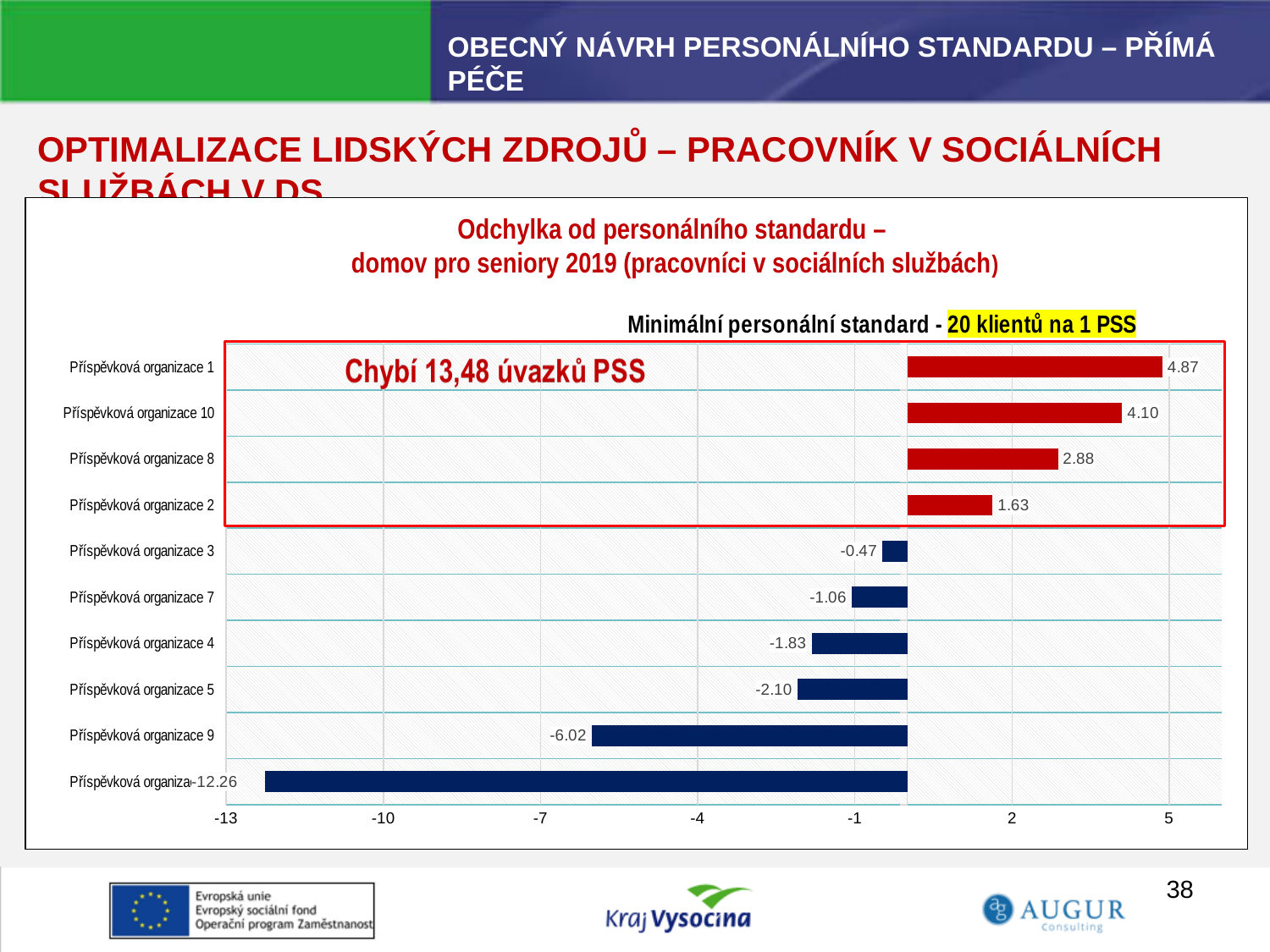
What is the value for Příspěvková organizace 1? 4.87 What minimum personnel standard is stated above the chart? 20 klientů na 1 PSS Is the value for Příspěvková organizace 9 greater or less than -4? less What type of chart is shown on the slide? bar chart What is the lowest value shown in the chart? -12.26 What is the value for Příspěvková organizace 9? -6.02 What is the difference between the values for Příspěvková organizace 1 and Příspěvková organizace 10? 0.77 What is the value for Příspěvková organizace 5? -2.10 What is the value for Příspěvková organizace 3? -0.47 How many organizations are shown in the chart? 10 Which organization has the highest value in the chart? Příspěvková organizace 1 Which is larger, the value for Příspěvková organizace 8 or Příspěvková organizace 2? Příspěvková organizace 8